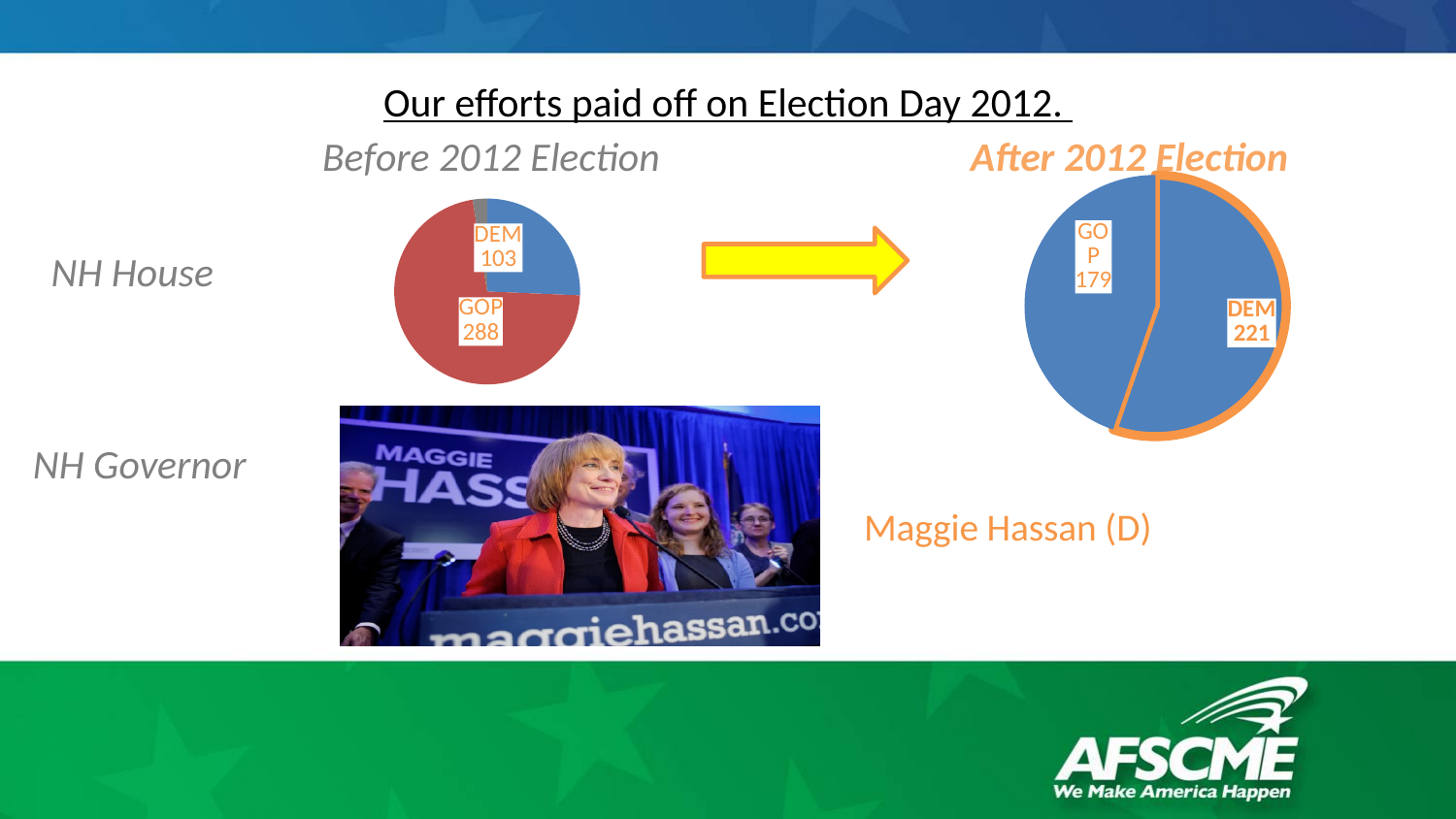
In the After 2012 Election pie chart, which party has the smaller slice? GOP What kind of chart is used to show the NH House results before and after the 2012 election? Pie chart In the Before 2012 Election pie chart, what is the difference between the GOP and DEM values? 185 In the Before 2012 Election pie chart, what is the value for GOP? 288 What is the title of the pie chart on the right side of the slide? After 2012 Election In the After 2012 Election pie chart, is the DEM value larger or smaller than the GOP value? larger In the After 2012 Election pie chart, what is the difference between the DEM and GOP values? 42 In the After 2012 Election pie chart, what is the value for DEM? 221 In the Before 2012 Election pie chart, which labeled party has the larger slice? GOP In the Before 2012 Election pie chart, what is the value for DEM? 103 In the After 2012 Election pie chart, what is the value for GOP? 179 How many labeled slices does the After 2012 Election pie chart have? 2